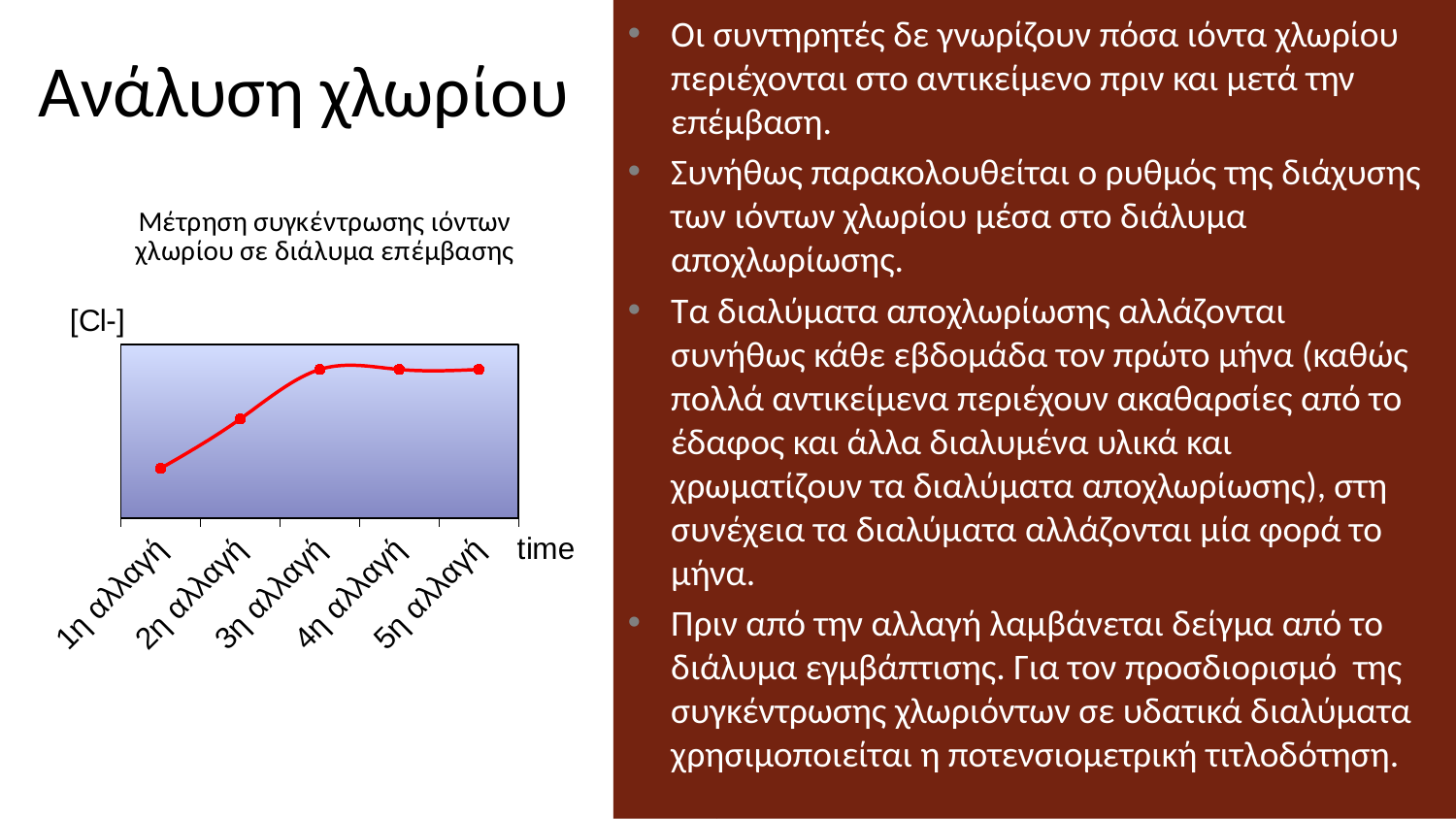
Do the values rise or fall from 1η αλλαγή to 3η αλλαγή? rise What is the label on the vertical axis of the chart? [Cl-] Which is larger, the value for 1η αλλαγή or the value for 2η αλλαγή? 2η αλλαγή What kind of chart is shown on the slide? line chart What is the label on the horizontal axis of the chart? time Which category has the lowest value on the chart? 1η αλλαγή How many data points are plotted on the line chart? 5 Which is larger, the value for 1η αλλαγή or the value for 5η αλλαγή? 5η αλλαγή Which is larger, the value for 2η αλλαγή or the value for 3η αλλαγή? 3η αλλαγή How many categories are shown on the x axis of the chart? 5